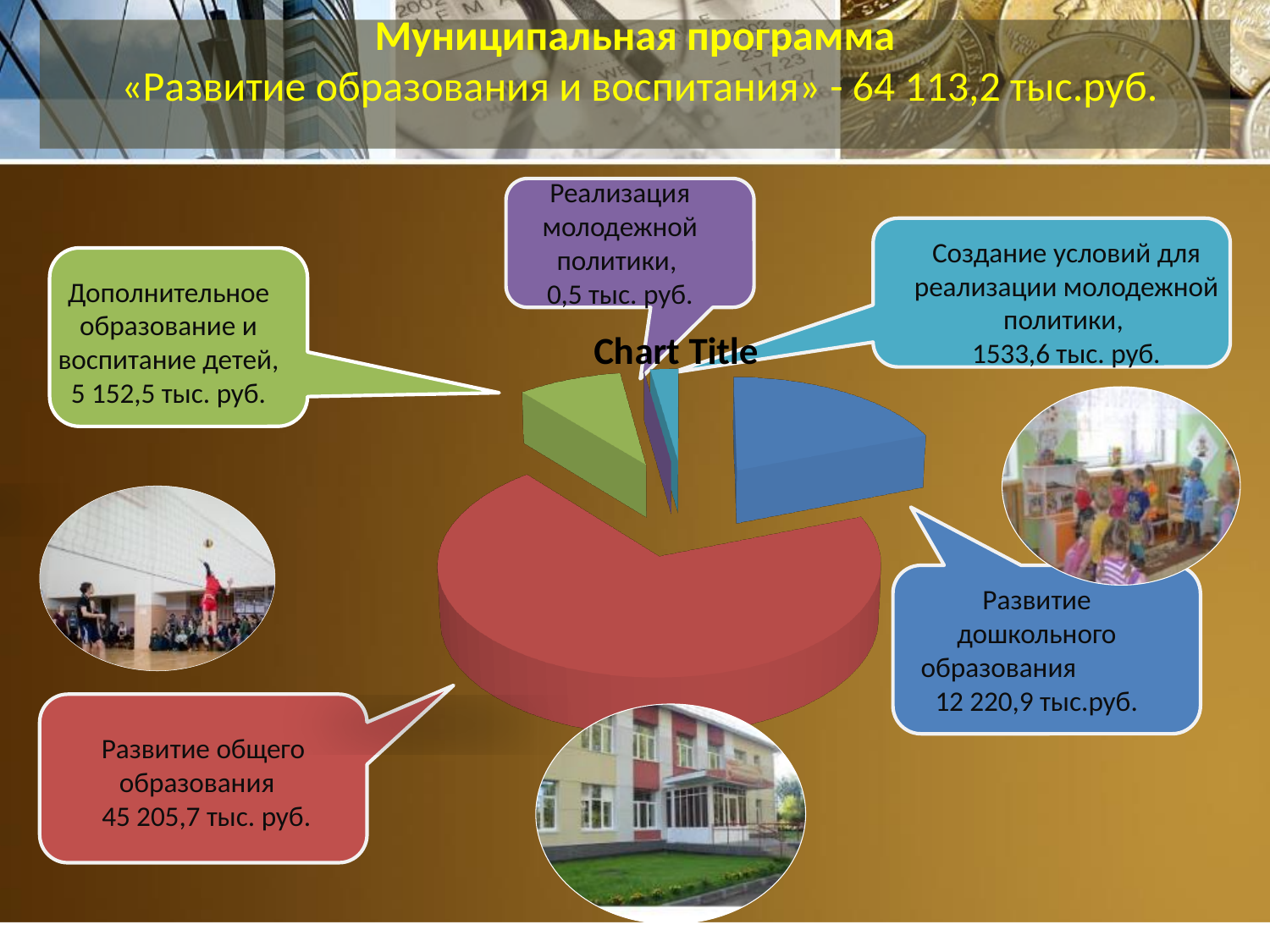
What is the value for «Реализация молодежной политики»? 0,5 тыс. руб. What is the difference between «Развитие общего образования» and «Развитие дошкольного образования»? 32 984,8 тыс. руб. What is the value for «Дополнительное образование и воспитание детей»? 5 152,5 тыс. руб. Which category has the largest slice of the pie? Развитие общего образования What is the value for «Развитие общего образования»? 45 205,7 тыс. руб. What kind of chart is shown on the slide? pie chart Which category has the smallest slice of the pie? Реализация молодежной политики How many slices does the pie chart have? 5 What is the value for «Развитие дошкольного образования»? 12 220,9 тыс.руб. Which is larger: «Развитие дошкольного образования» or «Дополнительное образование и воспитание детей»? Развитие дошкольного образования What title is printed above the pie chart? Chart Title What is the value for «Создание условий для реализации молодежной политики»? 1533,6 тыс. руб.